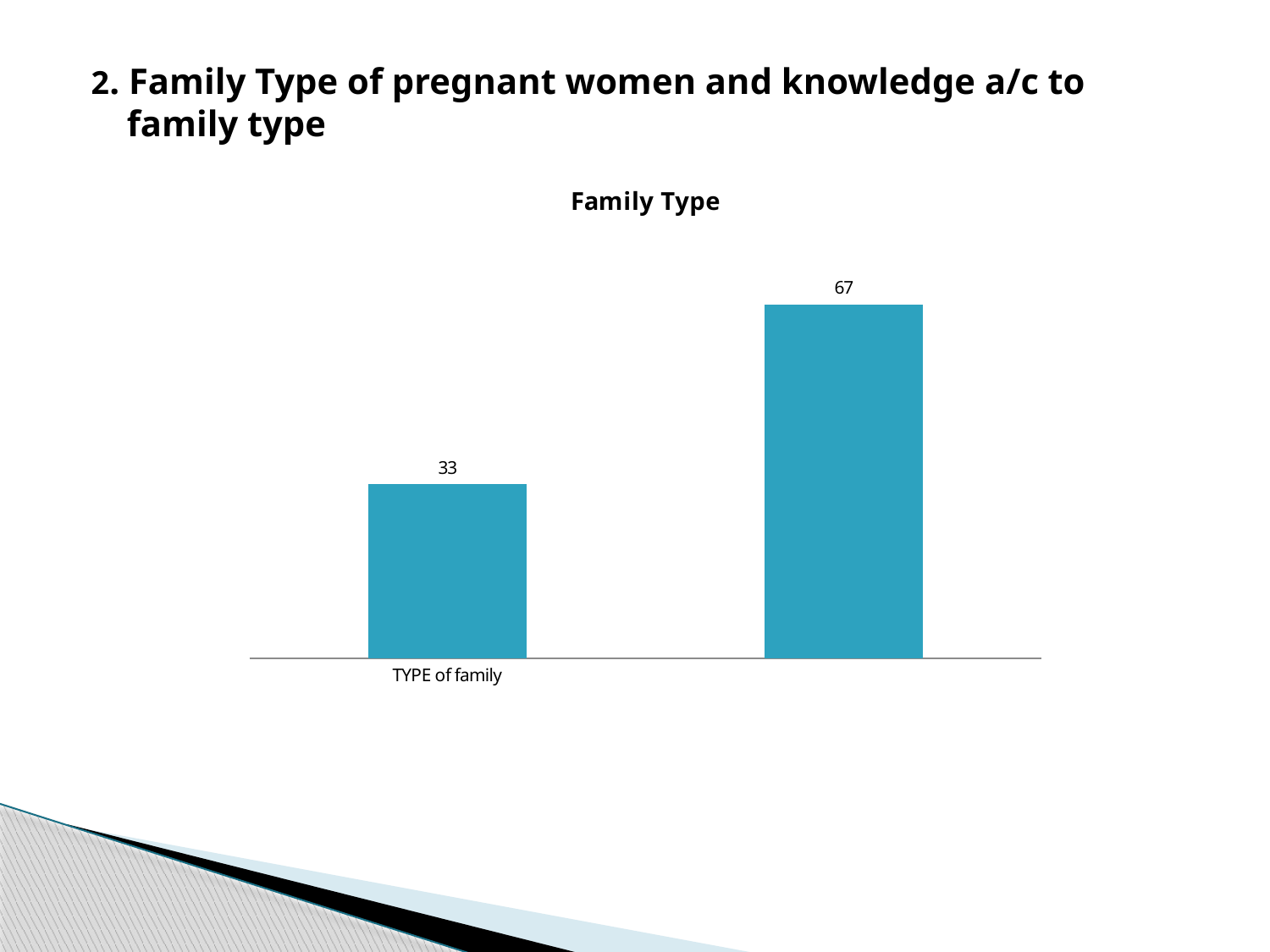
How many bars are plotted in the chart? 2 What is the category label printed under the left bar? TYPE of family What kind of chart is shown on the slide? bar chart Is the value of the left bar larger or smaller than the value of the right bar? smaller What is the value shown on the right bar of the chart? 67 What is the value shown on the left bar of the chart? 33 What is the value of the bar labelled 'TYPE of family'? 33 What is the difference between the values of the right bar and the left bar? 34 What is the title of the chart? Family Type Which bar has the lower value, the left bar or the right bar? the left bar Which bar has the higher value, the left bar or the right bar? the right bar